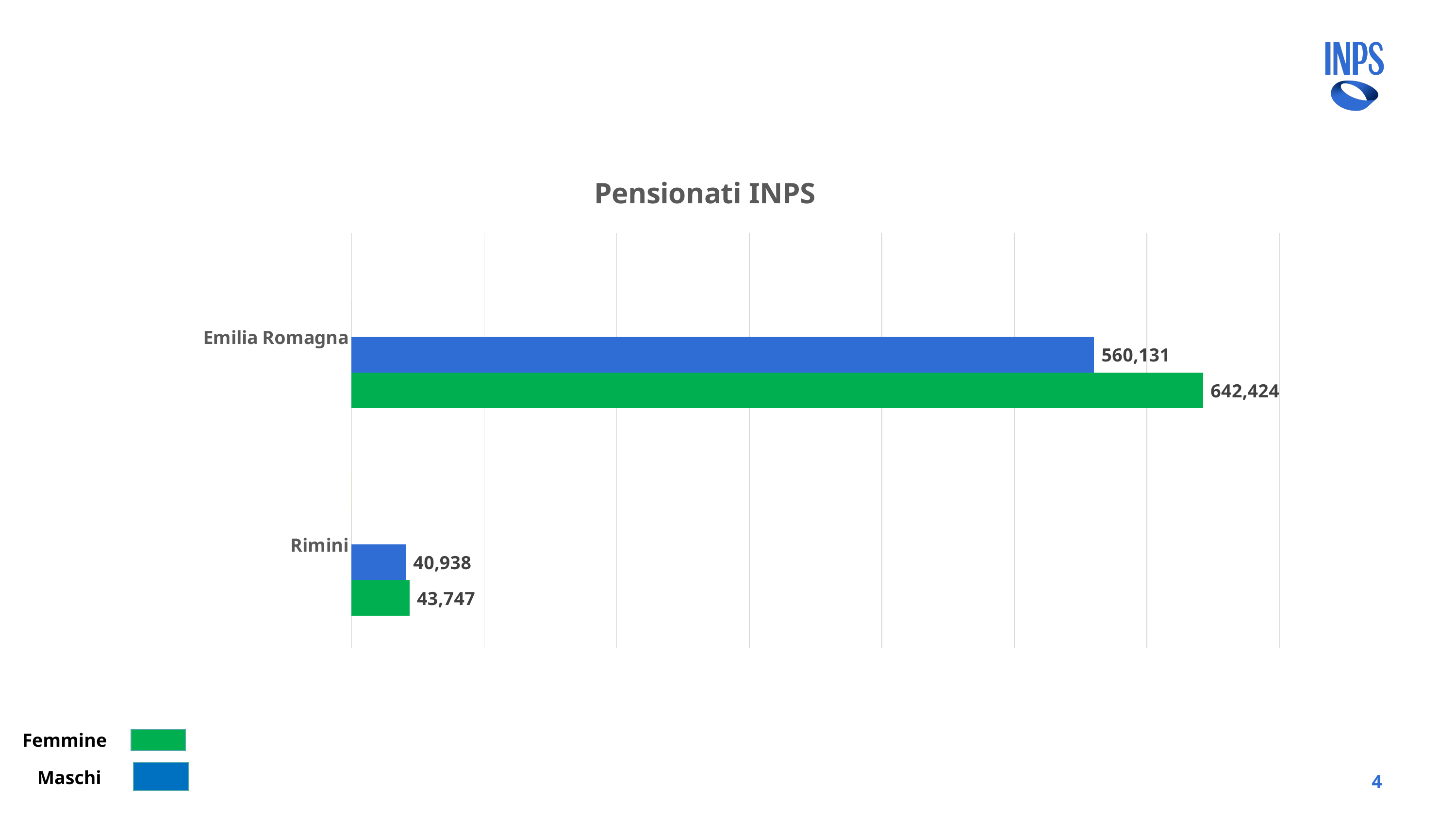
What is the value for Femmine in Rimini? 43,747 What kind of chart is shown on the slide? Bar chart What is the difference between Femmine and Maschi in Rimini? 2,809 In Emilia Romagna, which is larger, Femmine or Maschi? Femmine What is the difference between Femmine and Maschi in Emilia Romagna? 82,293 What is the value for Femmine in Emilia Romagna? 642,424 How many series does the legend list? 2 How many categories are shown on the chart? 2 Which bar has the lowest value in the chart? Maschi, Rimini What is the value for Maschi in Rimini? 40,938 Which bar has the highest value in the chart? Femmine, Emilia Romagna What is the value for Maschi in Emilia Romagna? 560,131